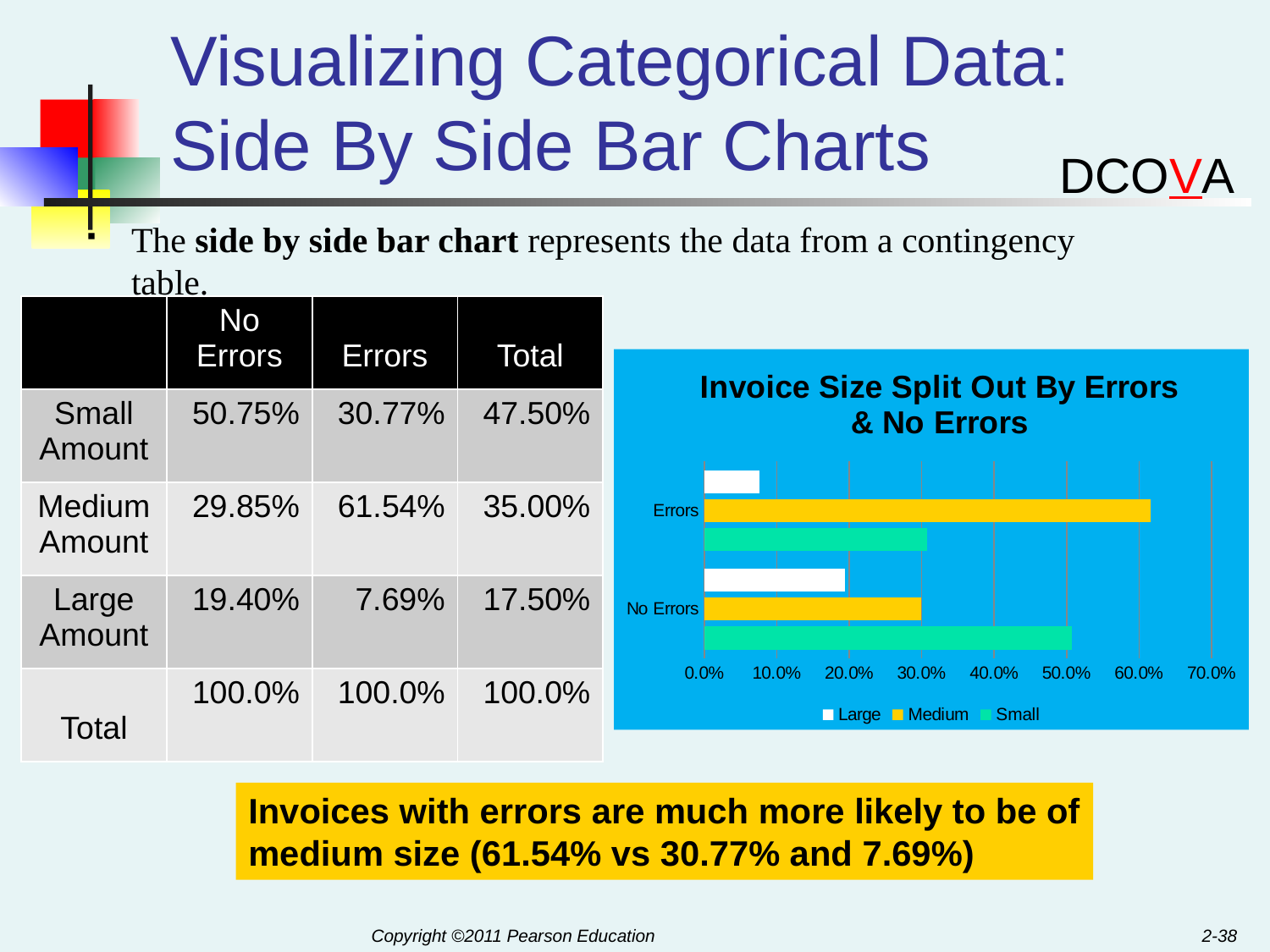
Is the Medium bar for Errors greater or less than 50.0%? greater Is the Large bar for Errors greater or less than 10.0%? less What is the title of the chart? Invoice Size Split Out By Errors & No Errors In the Errors category, which invoice size has the longest bar? Medium How many series does the chart legend list? 3 In the No Errors category, which invoice size has the longest bar? Small Which is larger: the Small bar for Errors or the Small bar for No Errors? No Errors What kind of chart is shown on the slide? bar chart Is the Small bar for No Errors greater or less than 40.0%? greater How many categories are shown on the vertical axis of the chart? 2 In the Errors category, which invoice size has the shortest bar? Large What percentage of invoices with errors are of medium size? 61.54%